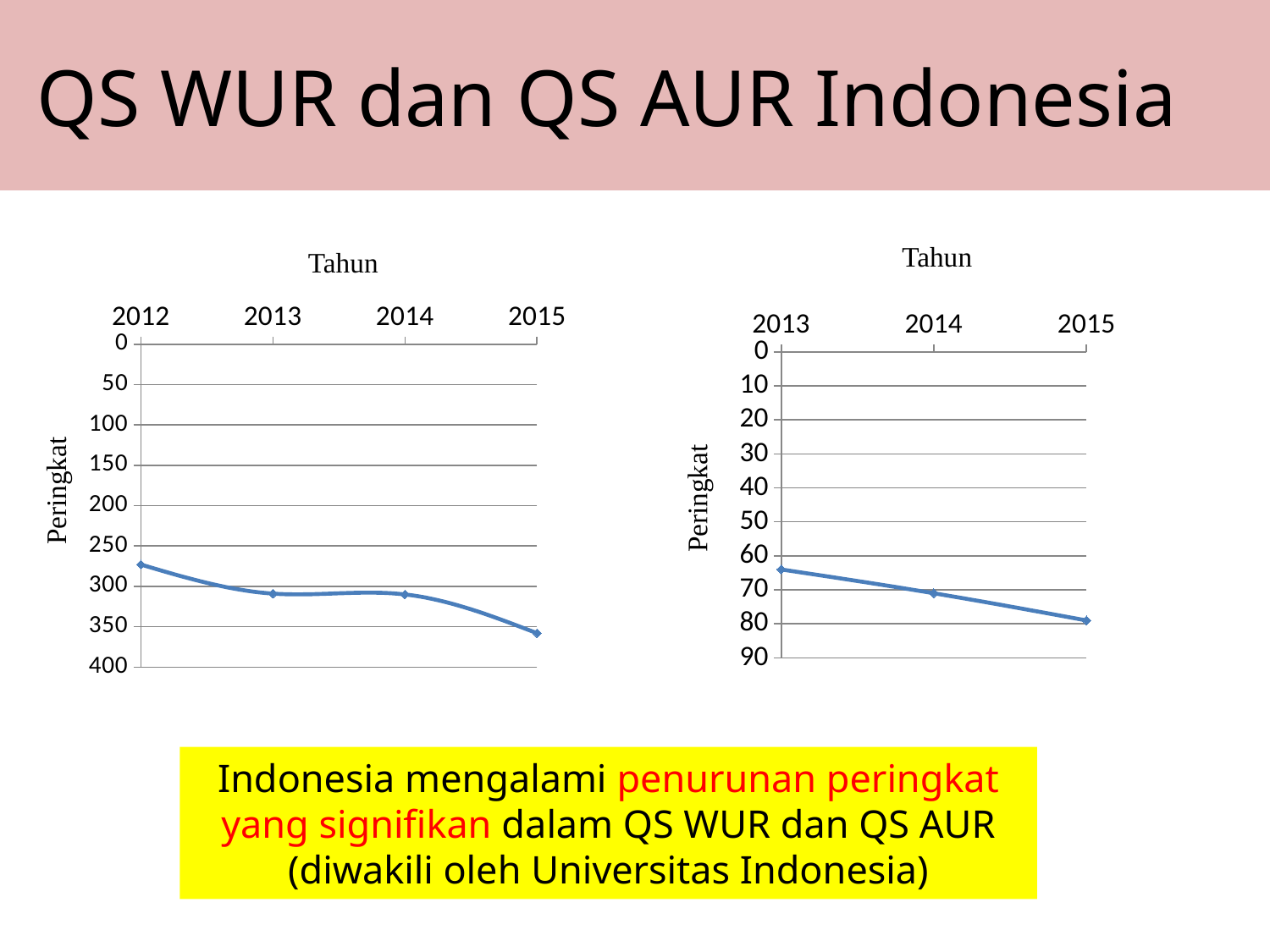
On the left chart, is the value for 2012 greater or less than 300? less On the left chart, is the value for 2015 greater or less than 300? greater On the right chart, which year has the largest plotted value (the point farthest from 0 on the reversed axis)? 2015 On the right chart, is the value for 2013 greater or less than 50? greater How many years are plotted on the x axis of the right chart? 3 On the right chart, do the plotted values move toward larger or smaller axis numbers from 2013 to 2015? larger How many years are plotted on the x axis of the left chart? 4 What is the label on the vertical axis of the left chart? Peringkat What kind of chart is the left chart on the slide? line chart On the left chart, which year has the smallest plotted value (the point closest to 0 on the reversed axis)? 2012